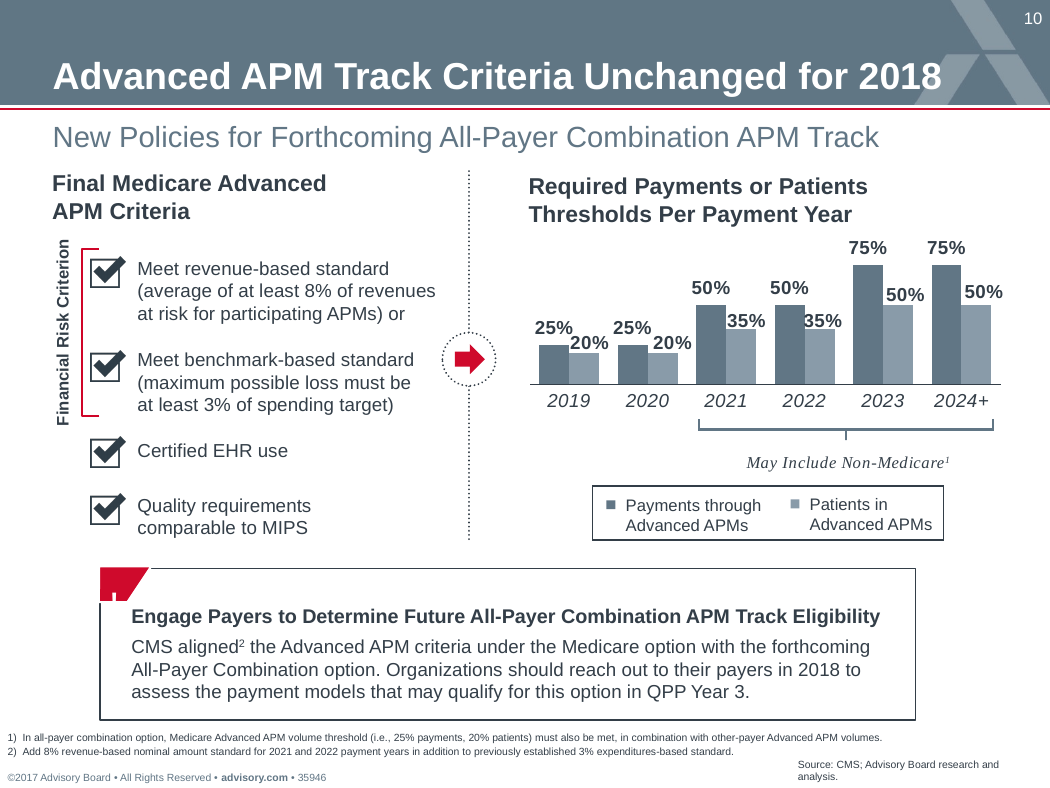
What is the difference between Payments through Advanced APMs and Patients in Advanced APMs in 2023? 25% How many series does the chart legend list? 2 What is the title of the chart? Required Payments or Patients Thresholds Per Payment Year What kind of chart is shown on the slide? Bar chart What is the value for Payments through Advanced APMs in 2023? 75% What is the value for Patients in Advanced APMs in 2024+? 50% What is the value for Payments through Advanced APMs in 2019? 25% Which year has the lowest value for Patients in Advanced APMs? 2019 and 2020 (20%) Which is larger in 2022: Payments through Advanced APMs or Patients in Advanced APMs? Payments through Advanced APMs Do the values for Payments through Advanced APMs rise or fall from 2019 to 2024+? Rise How many payment years are shown on the x axis of the chart? 6 What is the value for Patients in Advanced APMs in 2021? 35%